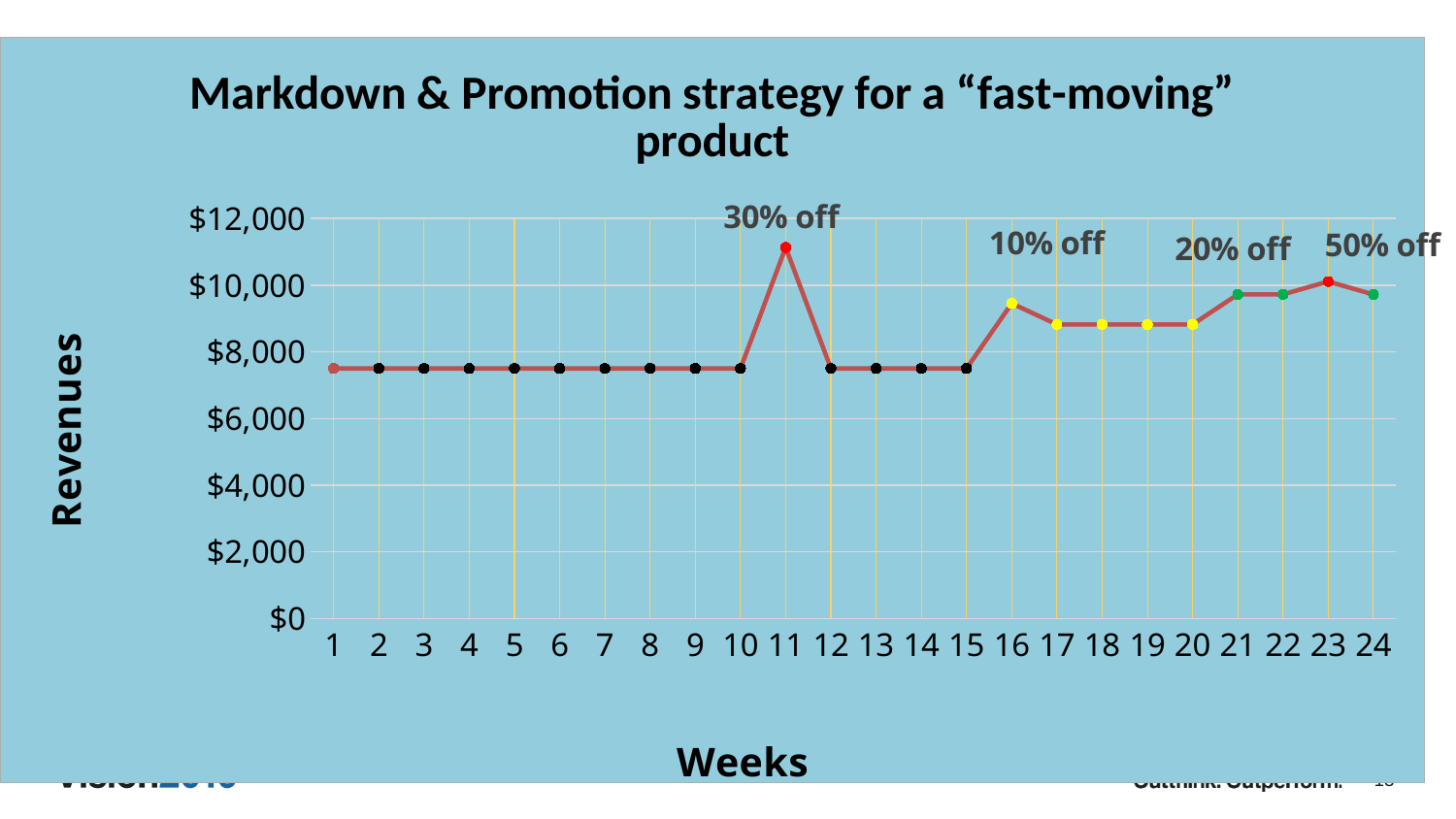
Is the revenue for week 11 greater or less than $10,000? greater What promotion label is shown above the peak at week 11? 30% off In which week is revenue highest? Week 11 How many weeks are plotted along the x axis? 24 What is the title of the chart? Markdown & Promotion strategy for a "fast-moving" product What kind of chart is shown on the slide? line chart Which week has higher revenue, week 16 or week 17? Week 16 Is the revenue for week 16 greater or less than $8,000? greater Which week has higher revenue, week 5 or week 21? Week 21 Is the revenue for week 1 greater or less than $8,000? less Which week has higher revenue, week 11 or week 23? Week 11